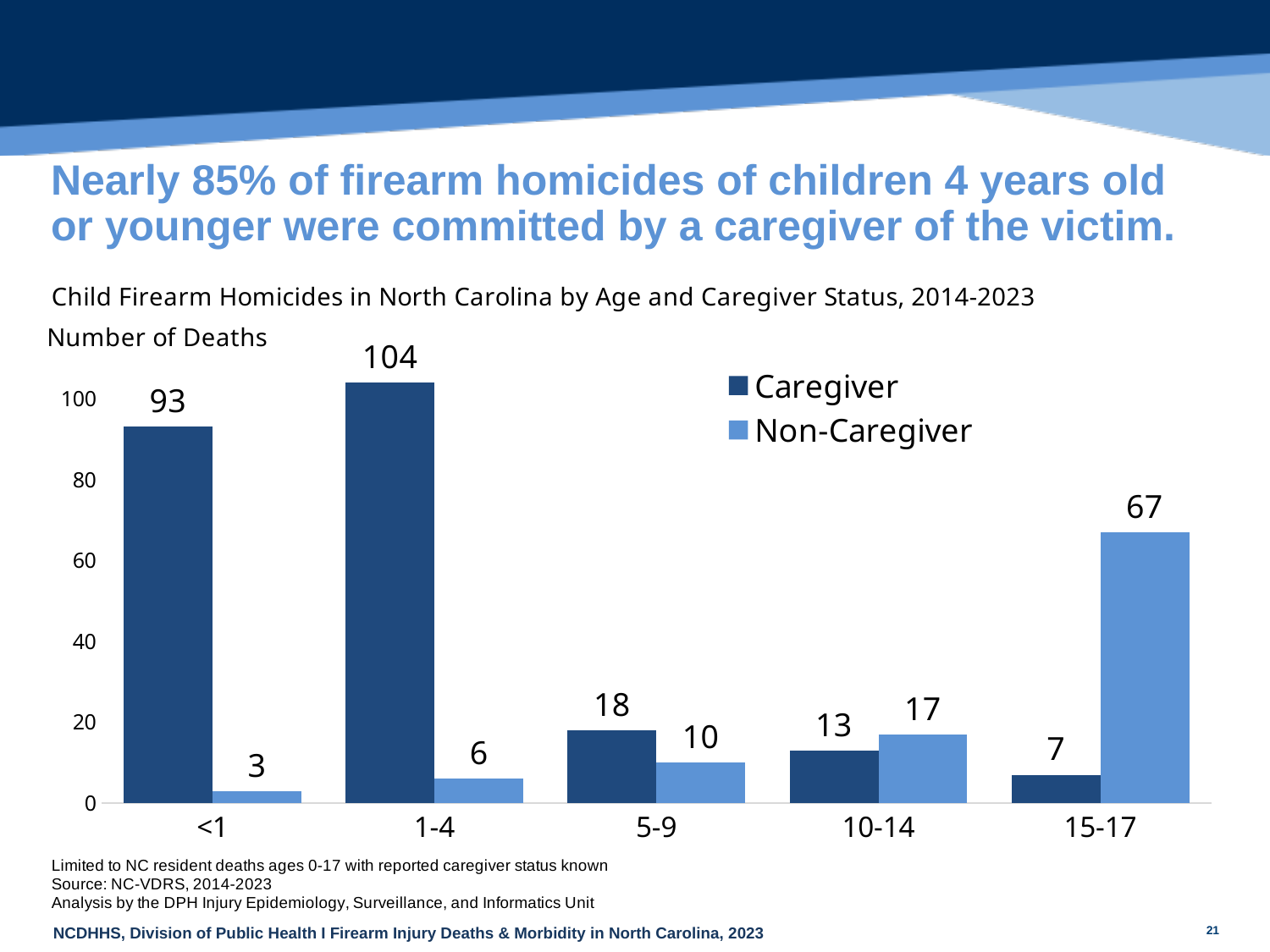
What kind of chart is shown on the slide? Bar chart How many series does the legend list? 2 Which is larger for the 10-14 age group, Caregiver or Non-Caregiver deaths? Non-Caregiver Do the Non-Caregiver values rise or fall from the 5-9 age group to the 15-17 age group? Rise What is the number of Non-Caregiver deaths for the <1 age group? 3 What is the number of Non-Caregiver deaths for the 15-17 age group? 67 How many age groups are shown on the x axis? 5 What is the number of Caregiver deaths for the 1-4 age group? 104 Which age group has the lowest number of Non-Caregiver deaths? <1 What is the title of the chart? Child Firearm Homicides in North Carolina by Age and Caregiver Status, 2014-2023 Which age group has the highest number of Caregiver deaths? 1-4 What is the difference between Caregiver and Non-Caregiver deaths in the <1 age group? 90